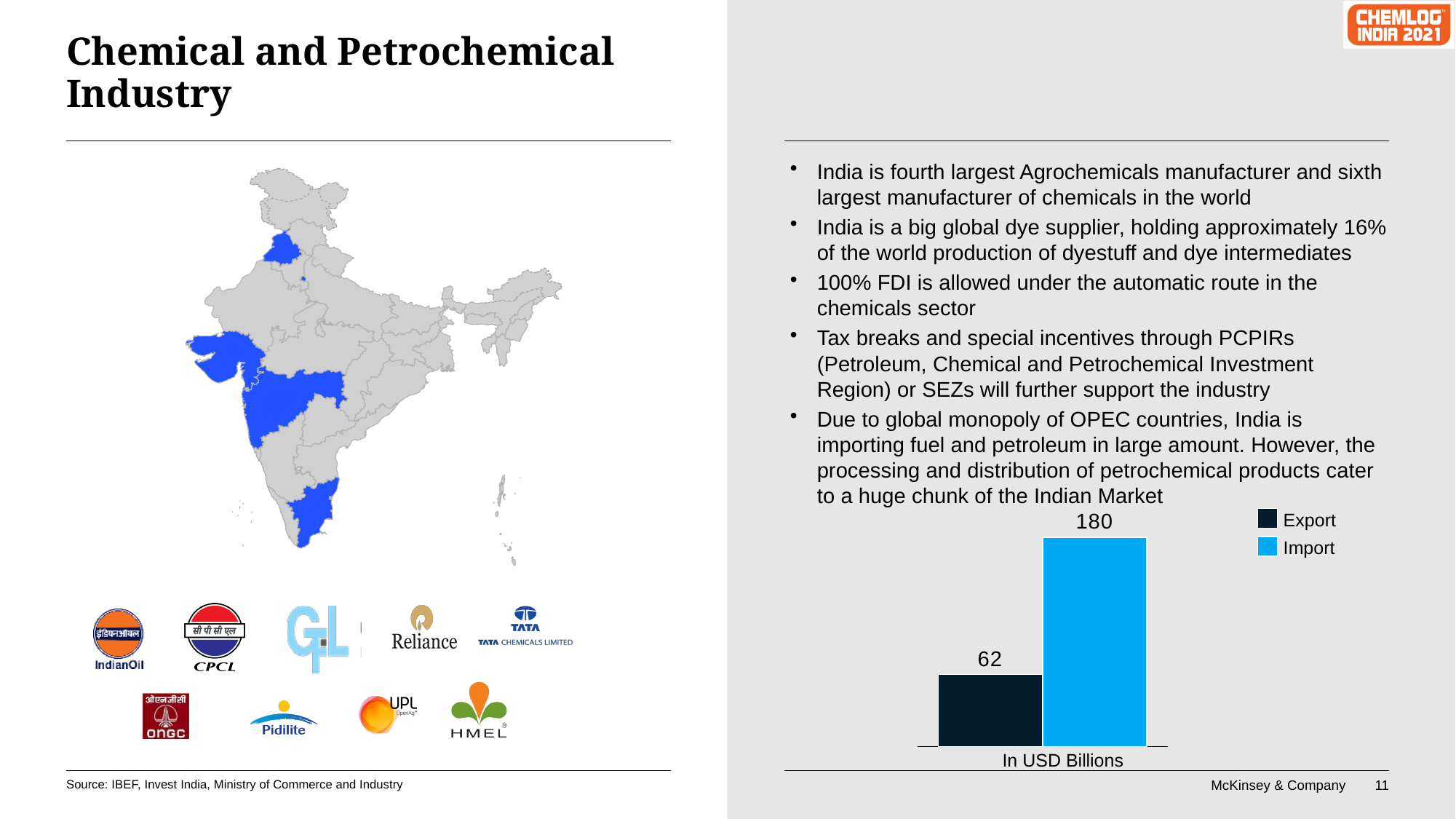
How many bars are plotted in the chart? 2 Which series has the lower value in the bar chart? Export What is the Import value shown in the bar chart? 180 Which series has the higher value in the bar chart, Export or Import? Import Which colour represents Import in the bar chart's legend? Light blue What kind of chart is shown on the right side of the slide? Bar chart What is the Export value shown in the bar chart? 62 Is the Import value larger than the Export value in the bar chart? Yes How many series does the legend of the bar chart list? 2 What is the difference between the Import and Export values in the bar chart? 118 What unit is the bar chart's data expressed in, according to the label below the bars? In USD Billions What is the total of the Export and Import values in the bar chart? 242